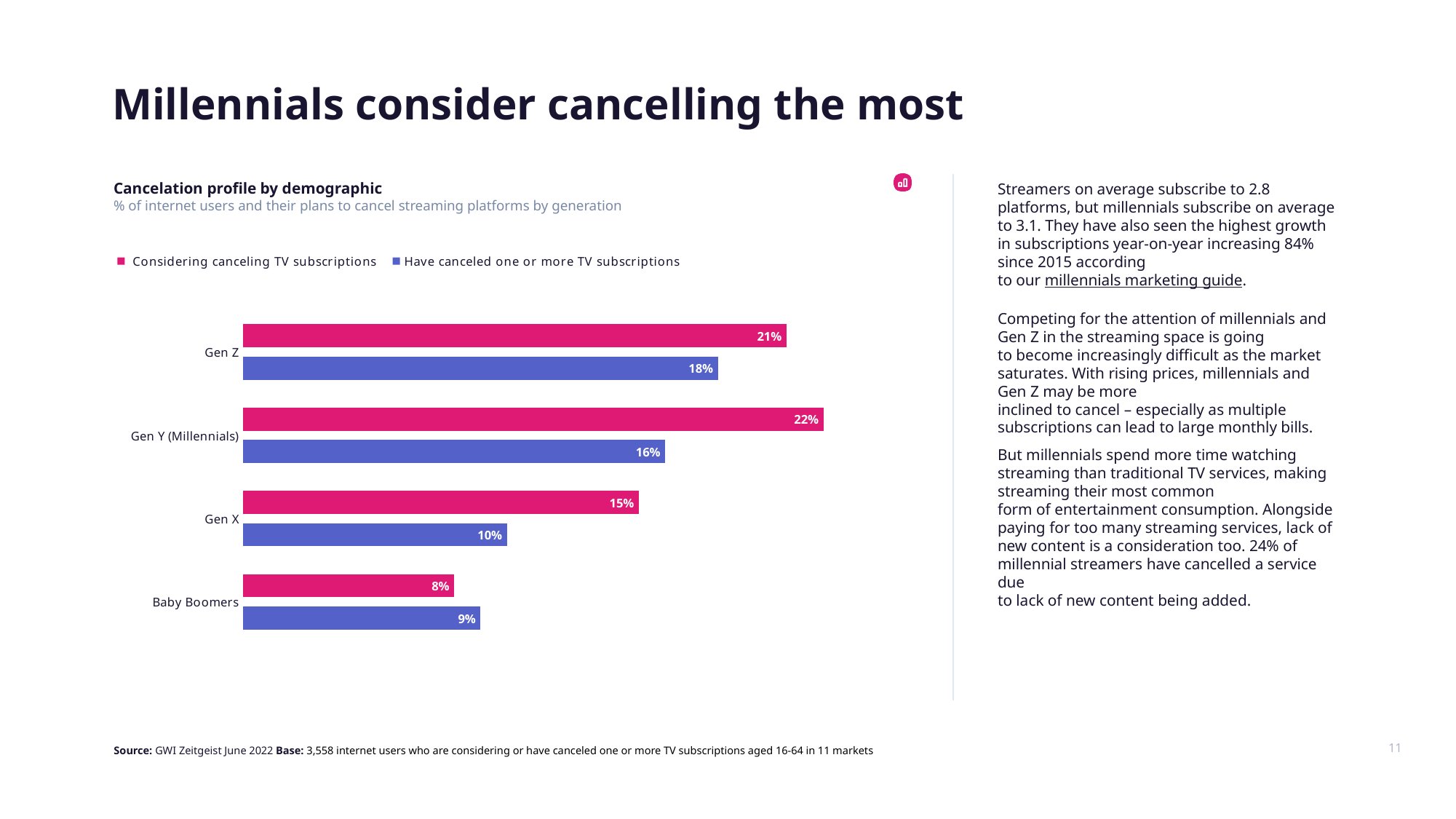
For Baby Boomers, which is larger: the share considering canceling TV subscriptions or the share that have canceled one or more? Have canceled one or more TV subscriptions What is the difference between the share of Gen Z considering canceling TV subscriptions and the share that have canceled one or more? 3% What percentage of Gen Y (Millennials) are considering canceling TV subscriptions? 22% Which generation has the lowest share that have canceled one or more TV subscriptions? Baby Boomers What kind of chart is shown on the slide? Bar chart Which generation has the highest share considering canceling TV subscriptions? Gen Y (Millennials) What percentage of Baby Boomers have canceled one or more TV subscriptions? 9% What is the title of the chart? Cancelation profile by demographic How many generations are shown in the chart? 4 What percentage of Gen X have canceled one or more TV subscriptions? 10% How many series does the legend list? 2 Which colour represents 'Considering canceling TV subscriptions' in the legend? Pink